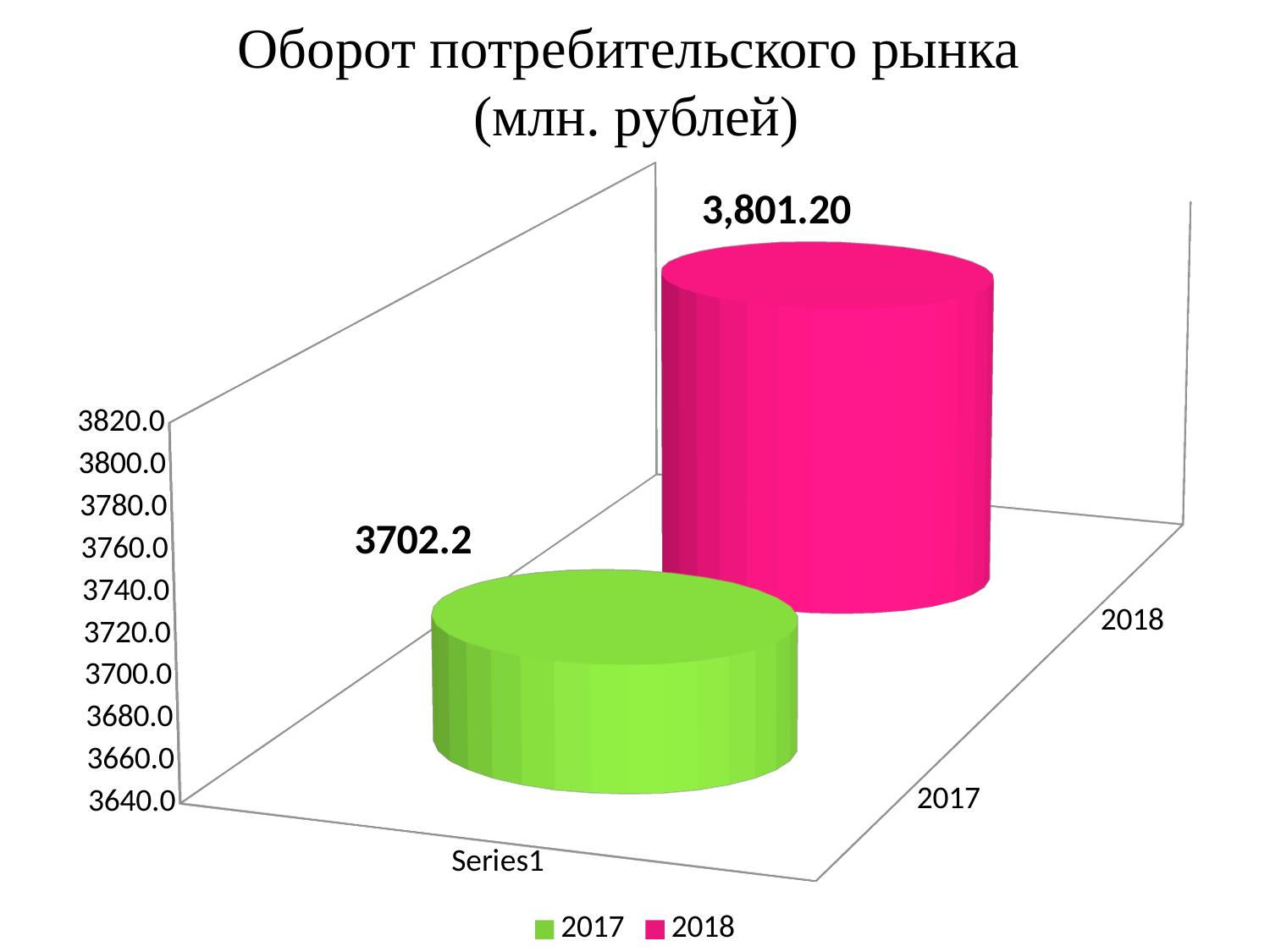
Is the value for 2018 greater or less than 3780? greater What is the title of the chart? Оборот потребительского рынка (млн. рублей) What is the value for 2017? 3702.2 What is the value for 2018? 3,801.20 What kind of chart is shown on the slide? bar chart How many series does the legend list? 2 Which year has the higher value, 2017 or 2018? 2018 Is the value for 2017 greater or less than 3720? less Which year has the highest value? 2018 What colour is the bar for 2018? pink What is the difference between the 2018 value and the 2017 value? 99 Which year has the lowest value? 2017